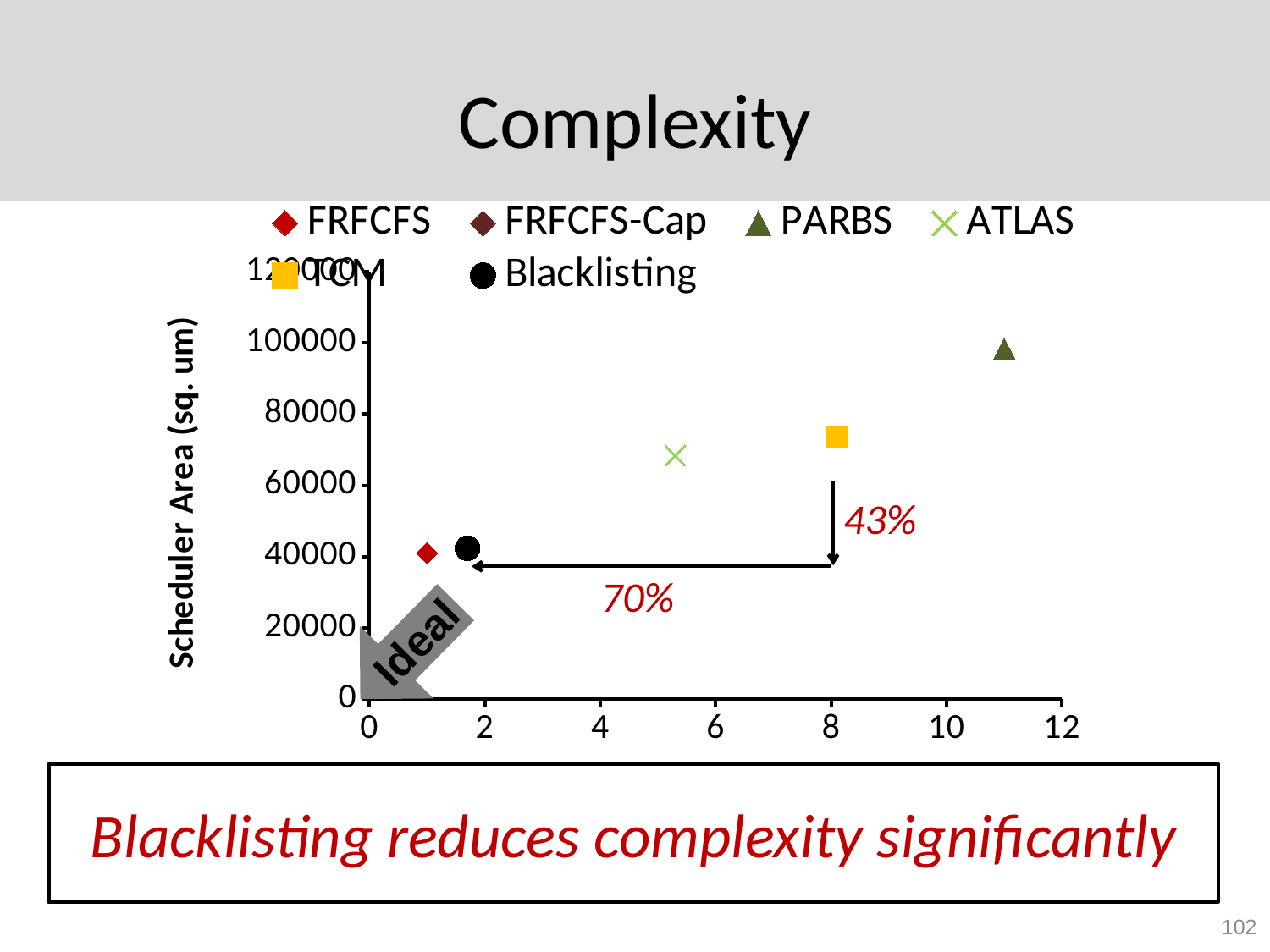
Is the x-axis value for Blacklisting greater or less than 4? less Is the scheduler area for Blacklisting greater or less than 60000? less Which has a larger scheduler area, PARBS or TCM? PARBS Is the scheduler area for ATLAS greater or less than 60000? greater Which has a larger scheduler area, TCM or Blacklisting? TCM What kind of chart is shown on the slide? scatter chart How many series does the legend list? 6 What percentage reduction is annotated next to the vertical arrow? 43% Which series has the highest scheduler area? PARBS What is the label of the vertical axis? Scheduler Area (sq. um)